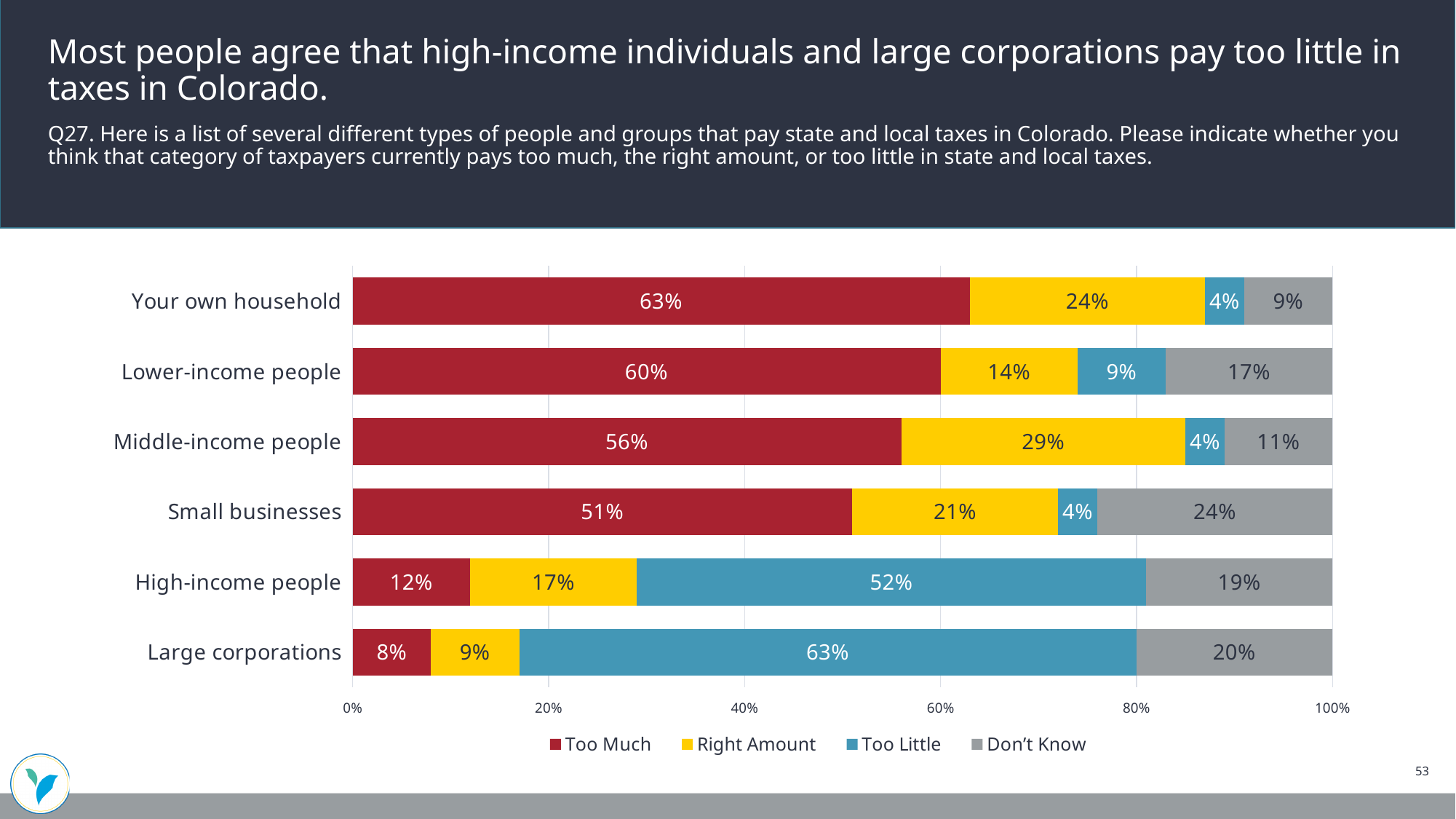
How many series does the legend list? 4 What percentage said large corporations pay too little in taxes? 63% What is the 'Don't Know' value for small businesses? 24% What kind of chart is shown on the slide? Stacked bar chart Which colour represents the 'Too Little' series in the legend? Blue Which category has the lowest 'Too Much' value? Large corporations What is the total of the stacked bar for lower-income people? 100% How many taxpayer categories are shown on the chart? 6 What is the difference between the 'Too Little' values for large corporations and high-income people? 11 percentage points Which is larger: the 'Too Much' value for lower-income people or for middle-income people? Lower-income people What percentage of respondents said their own household pays too much in taxes? 63% Which category has the highest 'Right Amount' value? Middle-income people